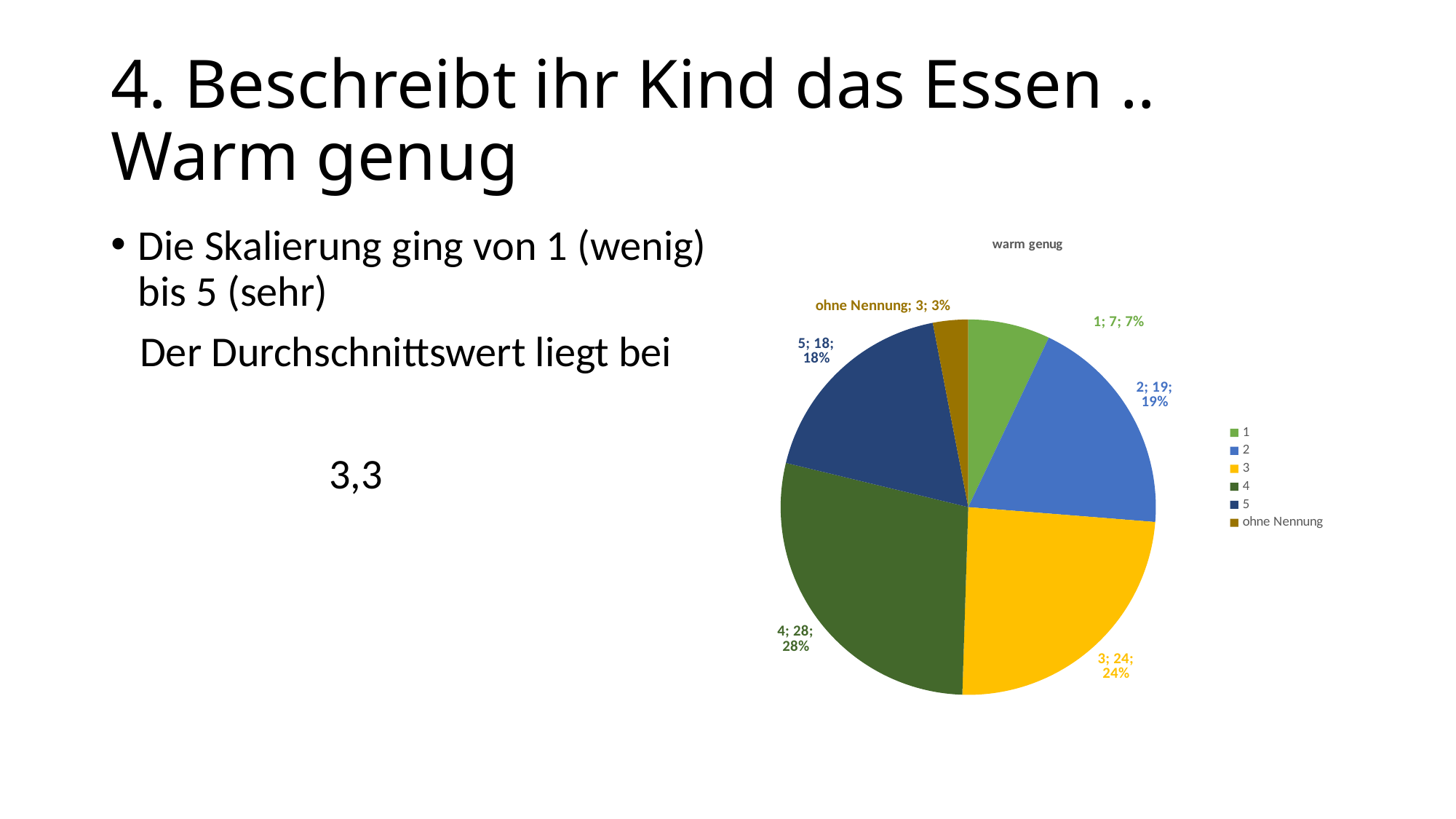
How many slices does the pie chart have? 6 Which is larger, the value for category 2 or the value for category 5? 2 What is the value for category 3? 24 What is the value for category 5? 18 What kind of chart is shown on the slide? pie chart What share of the pie does category 2 represent? 19% How many entries does the legend list? 6 Which category has the smallest slice? ohne Nennung What is the title of the chart? warm genug What is the value for 'ohne Nennung'? 3 What is the difference between the values for category 4 and category 1? 21 Which category has the largest slice? 4